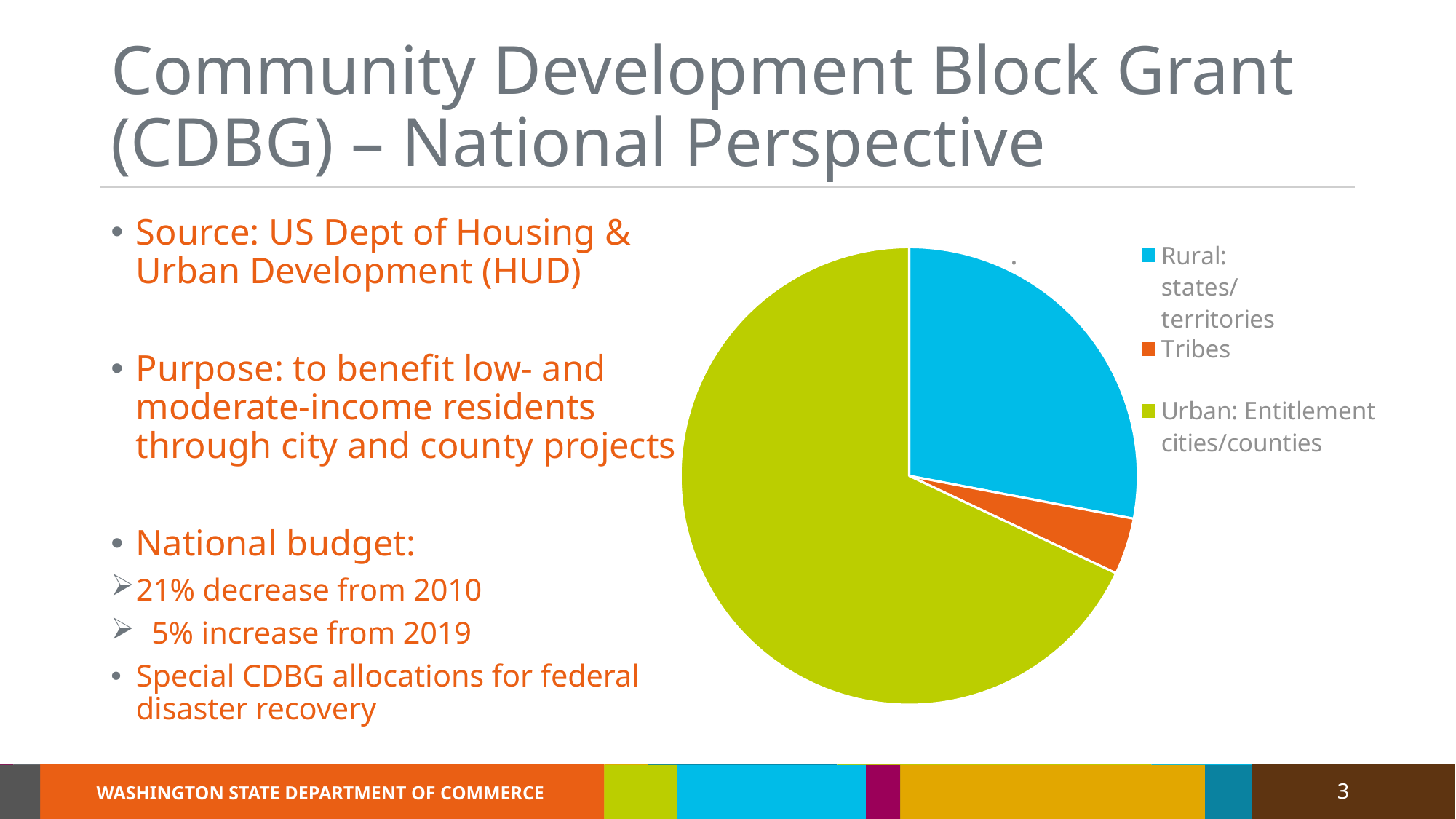
What colour is the Tribes slice in the pie chart? orange Which category has the smallest slice of the pie chart? Tribes Which slice is smaller in the pie chart: Tribes or Urban: Entitlement cities/counties? Tribes What kind of chart is shown on the slide? pie chart How many slices does the pie chart have? 3 Which category has the largest slice of the pie chart? Urban: Entitlement cities/counties Which slice is larger in the pie chart: Urban: Entitlement cities/counties or Rural: states/territories? Urban: Entitlement cities/counties How many entries does the pie chart's legend list? 3 Which category is shown in green in the pie chart? Urban: Entitlement cities/counties Which slice is larger in the pie chart: Rural: states/territories or Tribes? Rural: states/territories